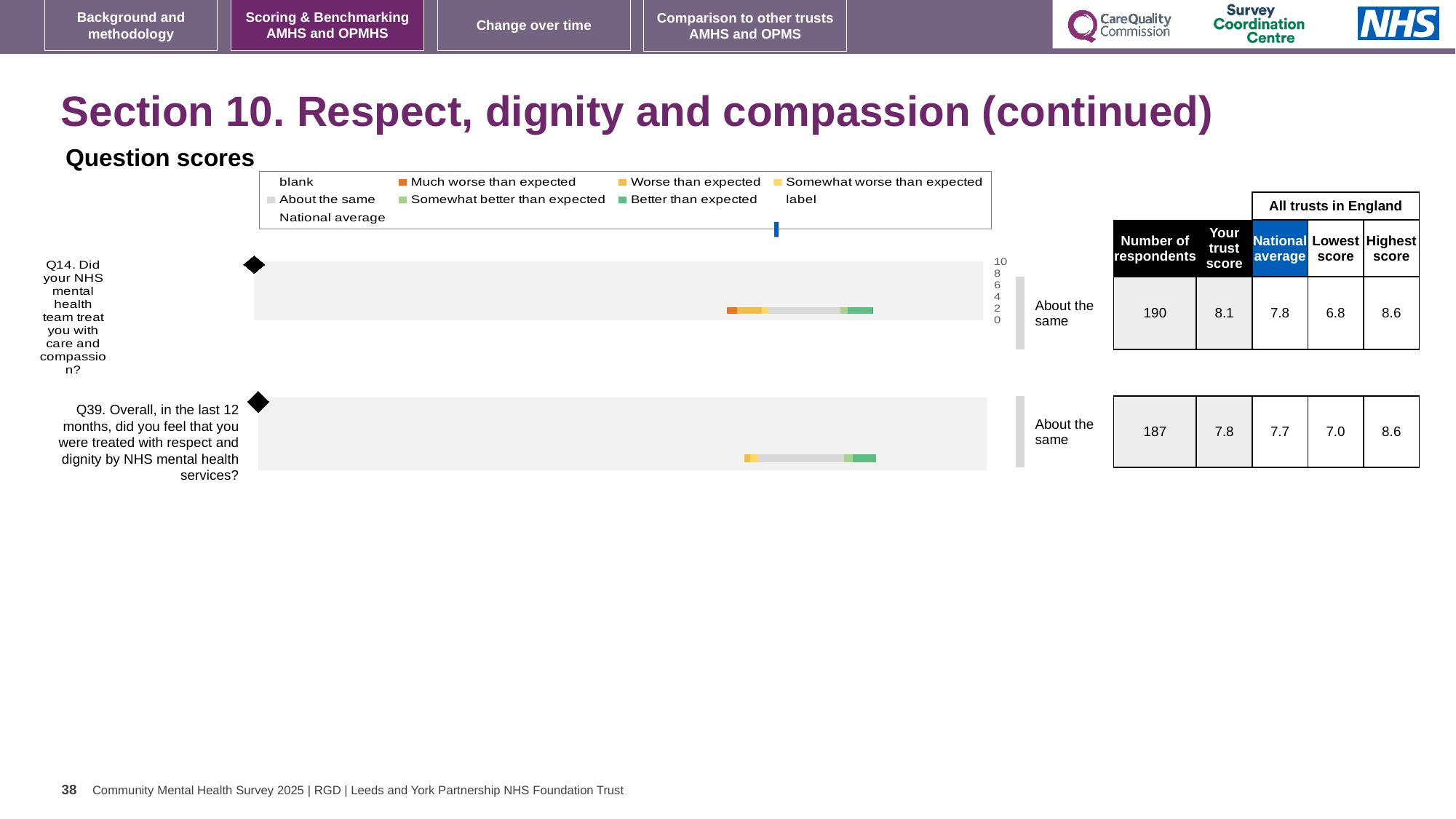
How many questions are plotted in the question scores chart? 2 What is the number of respondents shown for Q39? 187 What is the 'Your trust score' shown for Q14 (care and compassion)? 8.1 Which legend entry is shown in orange in the question scores chart? Much worse than expected What benchmark category label is shown next to the bar for Q39? About the same What is the 'Your trust score' shown for Q39 (respect and dignity)? 7.8 What is the lowest score across all trusts in England shown for Q39? 7.0 What is the highest score across all trusts in England shown for Q14? 8.6 What kind of chart is used to show the question scores on this slide? bar chart Which question has the higher 'Your trust score', Q14 or Q39? Q14 What is the difference between the trust score and the national average for Q14? 0.3 What is the national average shown for Q14? 7.8